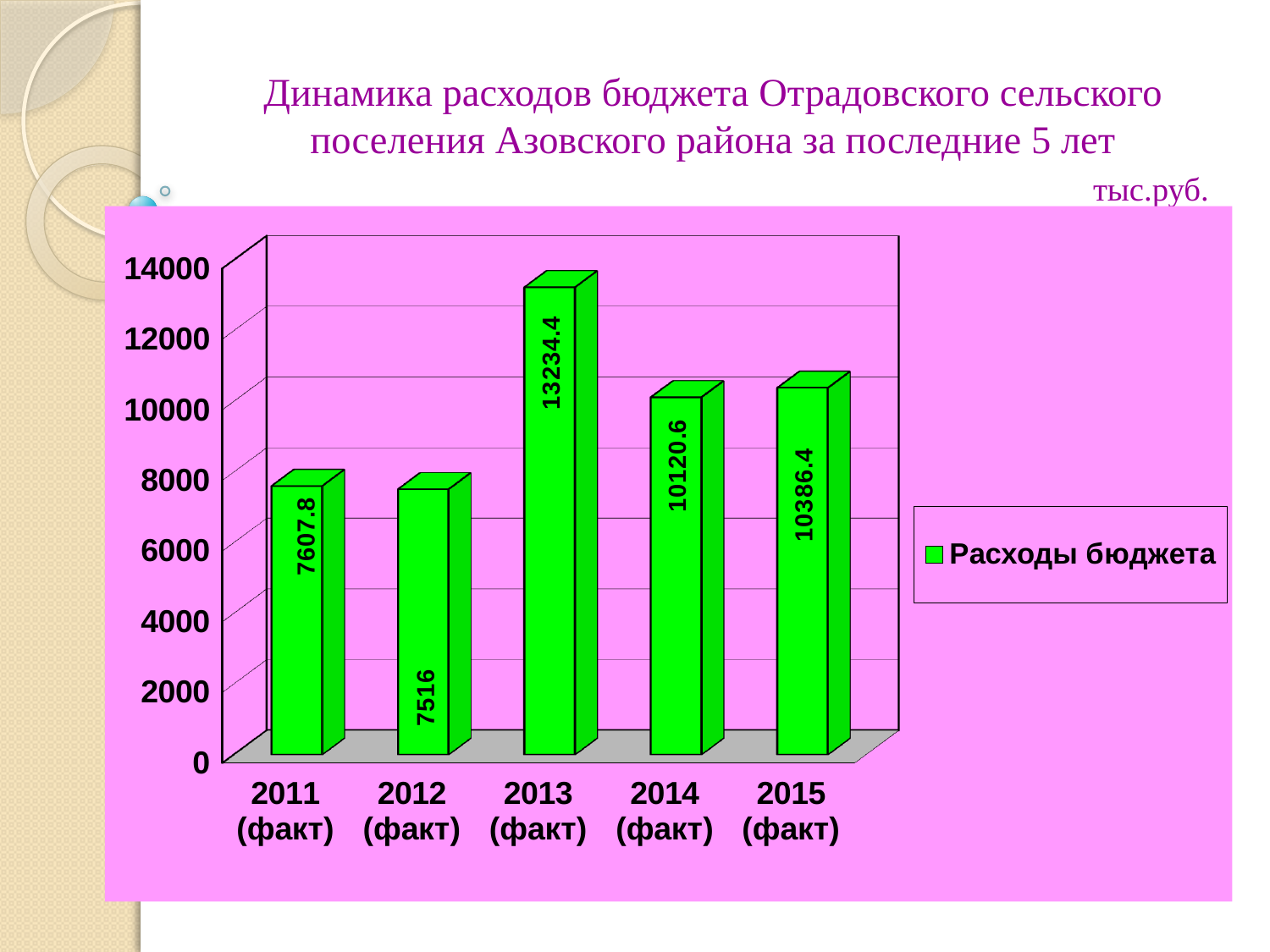
How many years are shown on the x axis? 5 Is the value for 2012 (факт) greater or less than 8000? less Which year has the highest budget expenditure? 2013 (факт) What is the legend entry for the series? Расходы бюджета Which year has the lowest budget expenditure? 2012 (факт) What is the value for 2013 (факт)? 13234.4 What is the difference between the values for 2013 (факт) and 2014 (факт)? 3113.8 What kind of chart is shown on the slide? bar chart Which is larger, the value for 2014 (факт) or 2015 (факт)? 2015 (факт) What is the value for 2011 (факт)? 7607.8 What is the value for 2015 (факт)? 10386.4 How many series does the legend list? 1